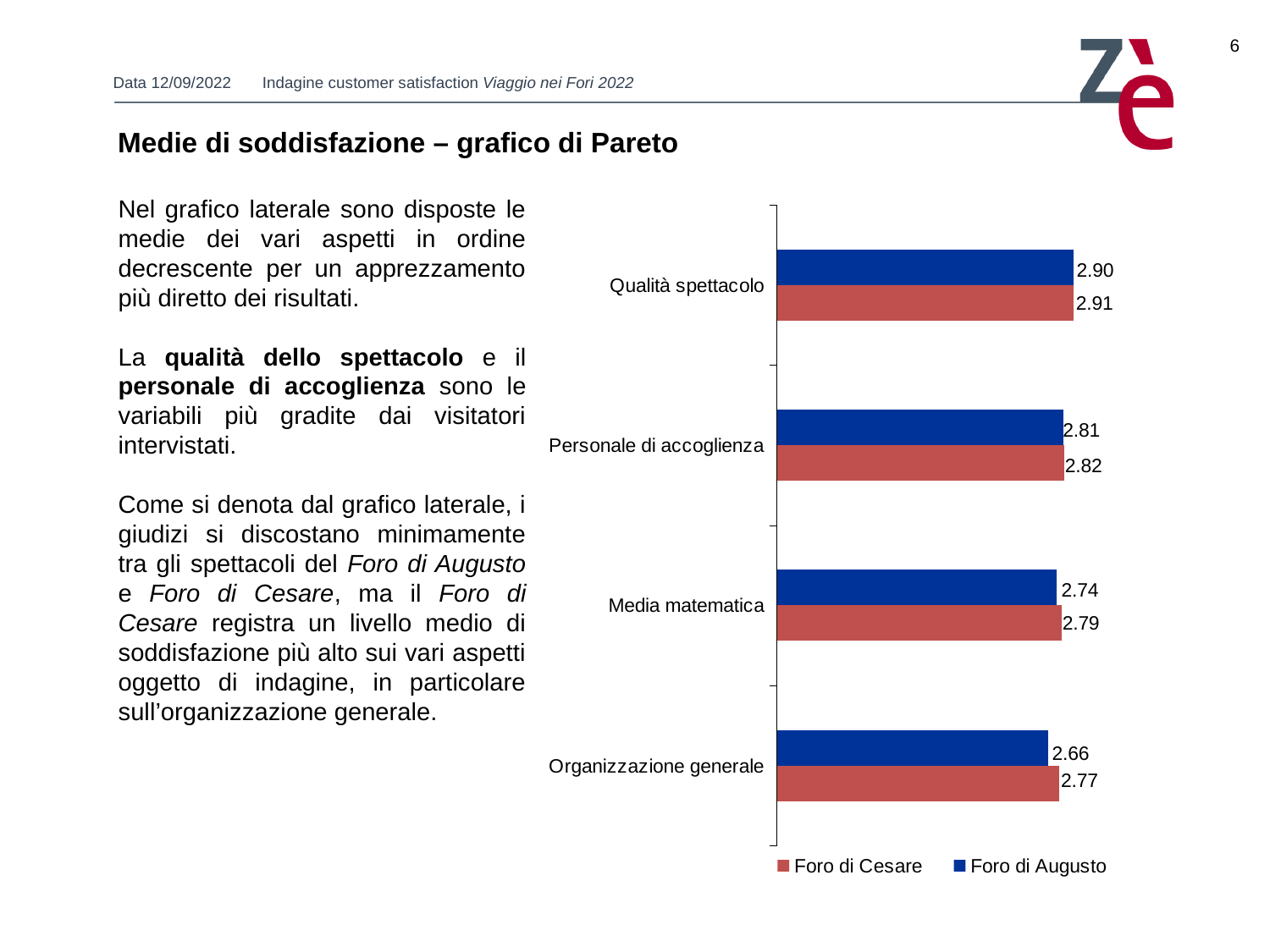
Which category has the highest value for Foro di Cesare? Qualità spettacolo Which category has the lowest value for Foro di Augusto? Organizzazione generale What is the value for Foro di Cesare for Qualità spettacolo? 2.91 What is the value for Foro di Cesare for Personale di accoglienza? 2.82 Which colour represents Foro di Augusto in the chart? blue For Media matematica, which is larger: Foro di Cesare or Foro di Augusto? Foro di Cesare How many series does the chart legend list? 2 How many categories are shown on the chart? 4 What type of chart is shown on the slide? bar chart What is the difference between Foro di Cesare and Foro di Augusto for Organizzazione generale? 0.11 What is the value for Foro di Augusto for Organizzazione generale? 2.66 What is the value for Foro di Augusto for Media matematica? 2.74